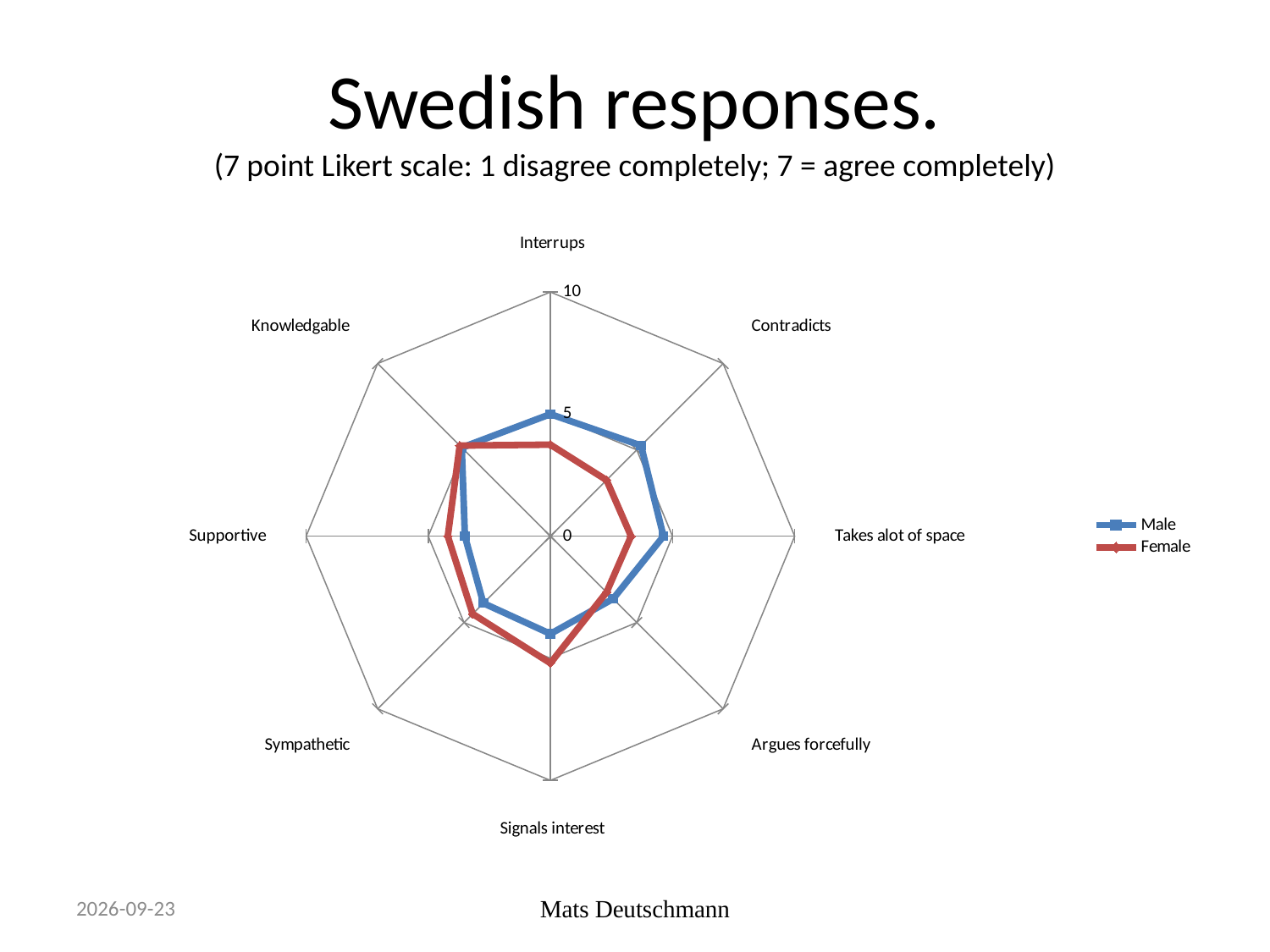
For Supportive, which series has the larger value, Male or Female? Female What colour is the Female series plotted in? Red For Signals interest, which series has the larger value, Male or Female? Female For Interrups, which series has the larger value, Male or Female? Male What kind of chart is shown on the slide? Radar chart Which series are listed in the legend? Male and Female How many categories (axes) does the radar chart have? 8 Is the Female value for Interrups greater or less than 5? less Is the Male value for Supportive greater or less than 5? less Is the Female value for Contradicts greater or less than 5? less How many series does the legend list? 2